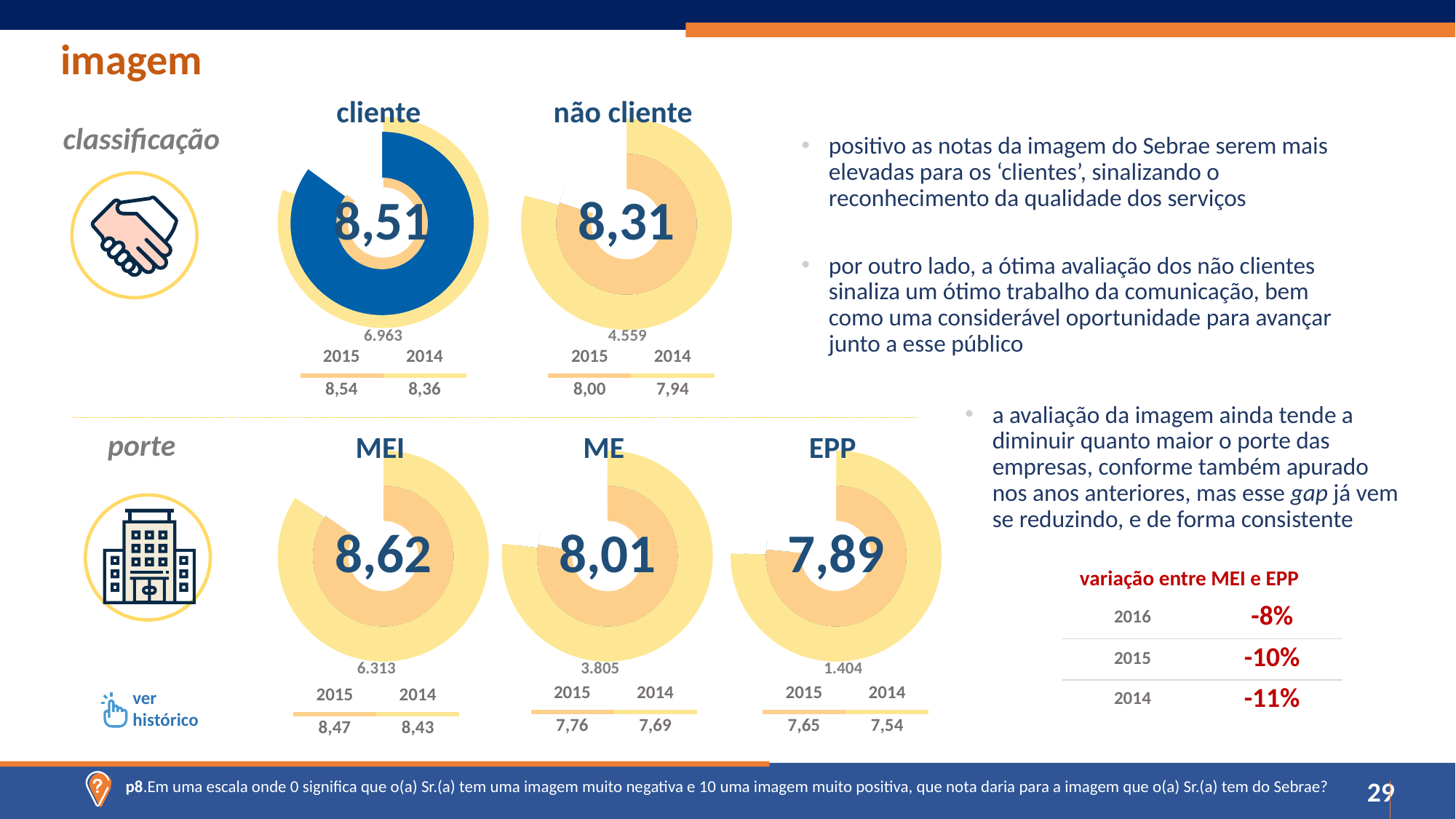
How many donut charts are shown in the 'porte' row of the slide? 3 Below the 'EPP' donut chart, what value is shown for 2014? 7,54 In the 'MEI' donut chart, what is the central value shown? 8,62 Among the three 'porte' donut charts (MEI, ME, EPP), which has the lowest central value? EPP Below the 'cliente' donut chart, what value is shown for 2015? 8,54 In the 'não cliente' donut chart, what is the central value shown? 8,31 Which has a larger central value, the 'ME' donut chart or the 'EPP' donut chart? ME In the 'cliente' donut chart, what is the central value shown? 8,51 What is the difference between the central values of the 'cliente' and 'não cliente' donut charts? 0,20 Among the three 'porte' donut charts (MEI, ME, EPP), which has the highest central value? MEI What type of chart is used to display the 'cliente' and 'não cliente' values? Donut (pie) chart In the 'EPP' donut chart, what is the central value shown? 7,89